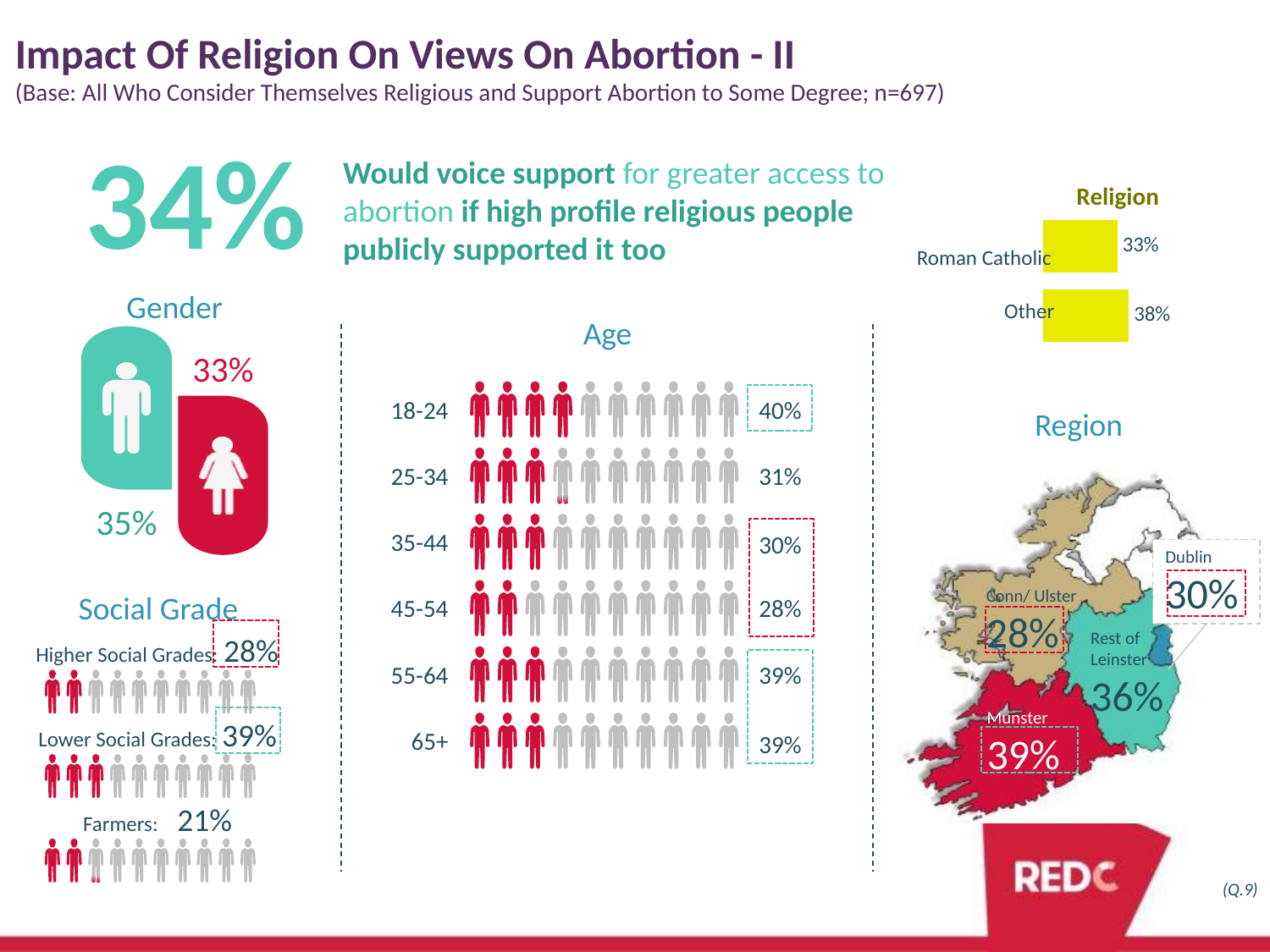
In the Region map, what is the value for Rest of Leinster? 36% In the Region map, which region has the highest value? Munster In the Religion chart, what is the value for Other? 38% In the Social Grade chart, which is larger, Higher Social Grades or Lower Social Grades? Lower Social Grades In the Social Grade chart, what is the value for Farmers? 21% In the Age chart, what is the value for 25-34? 31% In the Religion chart, what is the value for Roman Catholic? 33% What kind of chart is the Religion chart? Bar chart In the Religion chart, what is the difference between Other and Roman Catholic? 5% In the Age chart, which age group has the lowest value? 45-54 In the Age chart, which age group has the highest value? 18-24 How many age groups are shown in the Age chart? 6